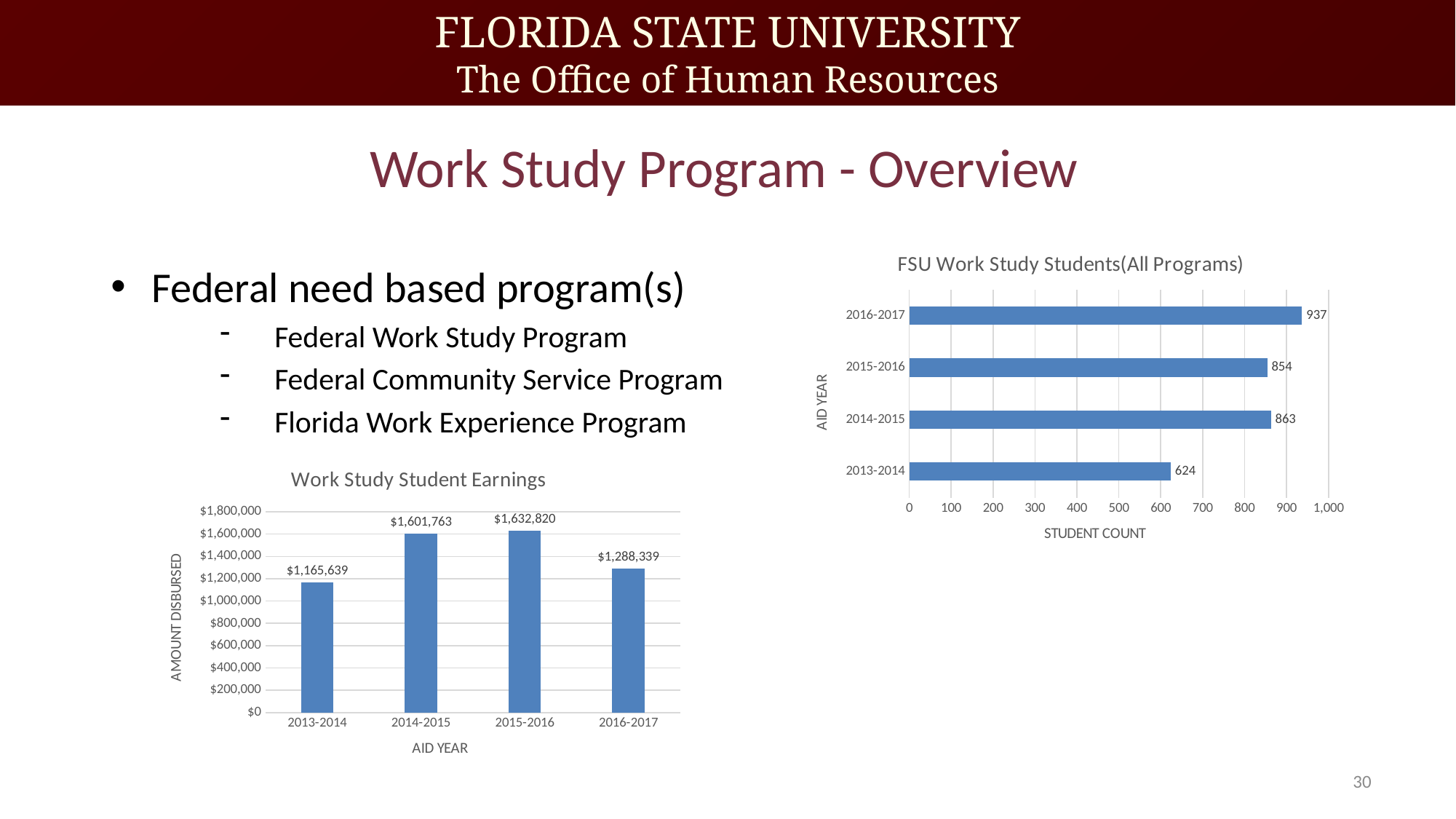
In the 'FSU Work Study Students(All Programs)' chart, what is the label of the horizontal axis? STUDENT COUNT In the 'FSU Work Study Students(All Programs)' chart, what is the student count for 2016-2017? 937 In the 'FSU Work Study Students(All Programs)' chart, which is larger: the student count for 2014-2015 or 2015-2016? 2014-2015 In the 'Work Study Student Earnings' chart, is the value for 2016-2017 greater or less than $1,400,000? less In the 'Work Study Student Earnings' chart, how many aid years are shown? 4 In the 'Work Study Student Earnings' chart, which aid year has the highest amount disbursed? 2015-2016 In the 'Work Study Student Earnings' chart, what is the difference between the amounts for 2015-2016 and 2016-2017? $344,481 In the 'Work Study Student Earnings' chart, what is the amount disbursed for 2013-2014? $1,165,639 What kind of chart is 'Work Study Student Earnings'? Bar chart In the 'FSU Work Study Students(All Programs)' chart, what is the difference between the student counts for 2016-2017 and 2013-2014? 313 In the 'Work Study Student Earnings' chart, which aid year has the lowest amount disbursed? 2013-2014 In the 'FSU Work Study Students(All Programs)' chart, which aid year has the lowest student count? 2013-2014